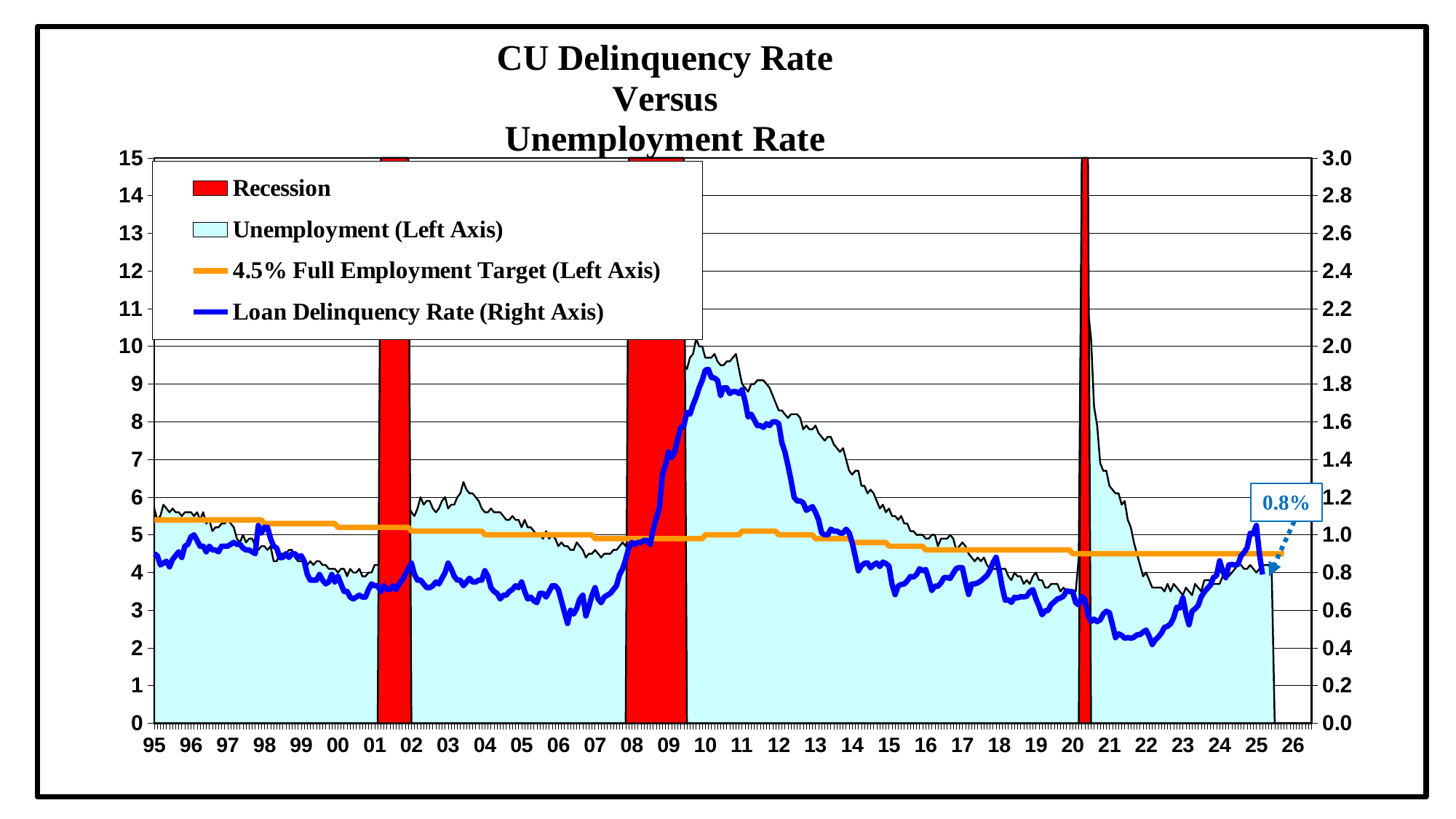
What full employment target value is given in the legend for the orange line? 4.5% Does the unemployment rate rise or fall from 2010 to 2019? fall How many series does the legend list? 4 What is the title of the chart? CU Delinquency Rate Versus Unemployment Rate In which year does the unemployment rate reach its highest peak? 2020 Is the unemployment rate at its 2010 peak greater or less than 9? greater On which axis is the Loan Delinquency Rate plotted? Right axis What kind of chart is the Loan Delinquency Rate series drawn as? line chart How many recession periods are shaded on the chart? 3 Which is larger, the unemployment rate in 2010 or in 2019? 2010 What value does the annotation at the right end of the Loan Delinquency Rate line show? 0.8%